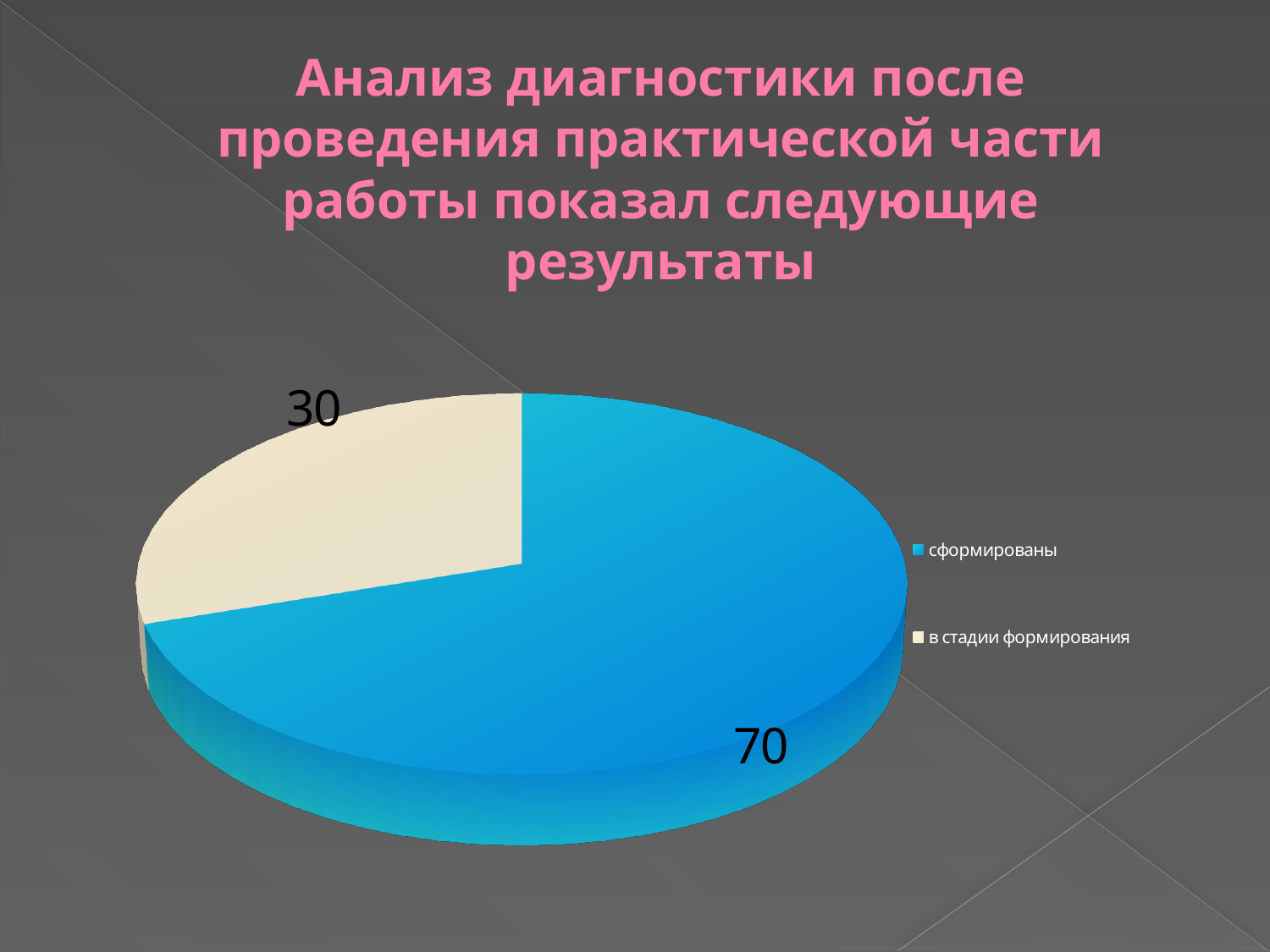
What colour is the "сформированы" slice? blue What kind of chart is shown on the slide? pie chart What is the difference between the values for "сформированы" and "в стадии формирования"? 40 What is the value for the "в стадии формирования" slice? 30 What colour is the "в стадии формирования" slice? beige What share of the pie does the "сформированы" slice represent? 70% Which category has the largest slice of the pie? сформированы What is the value for the "сформированы" slice? 70 How many slices does the pie chart have? 2 Which is larger, the value for "сформированы" or for "в стадии формирования"? сформированы How many entries does the legend list? 2 Which category has the smallest slice of the pie? в стадии формирования